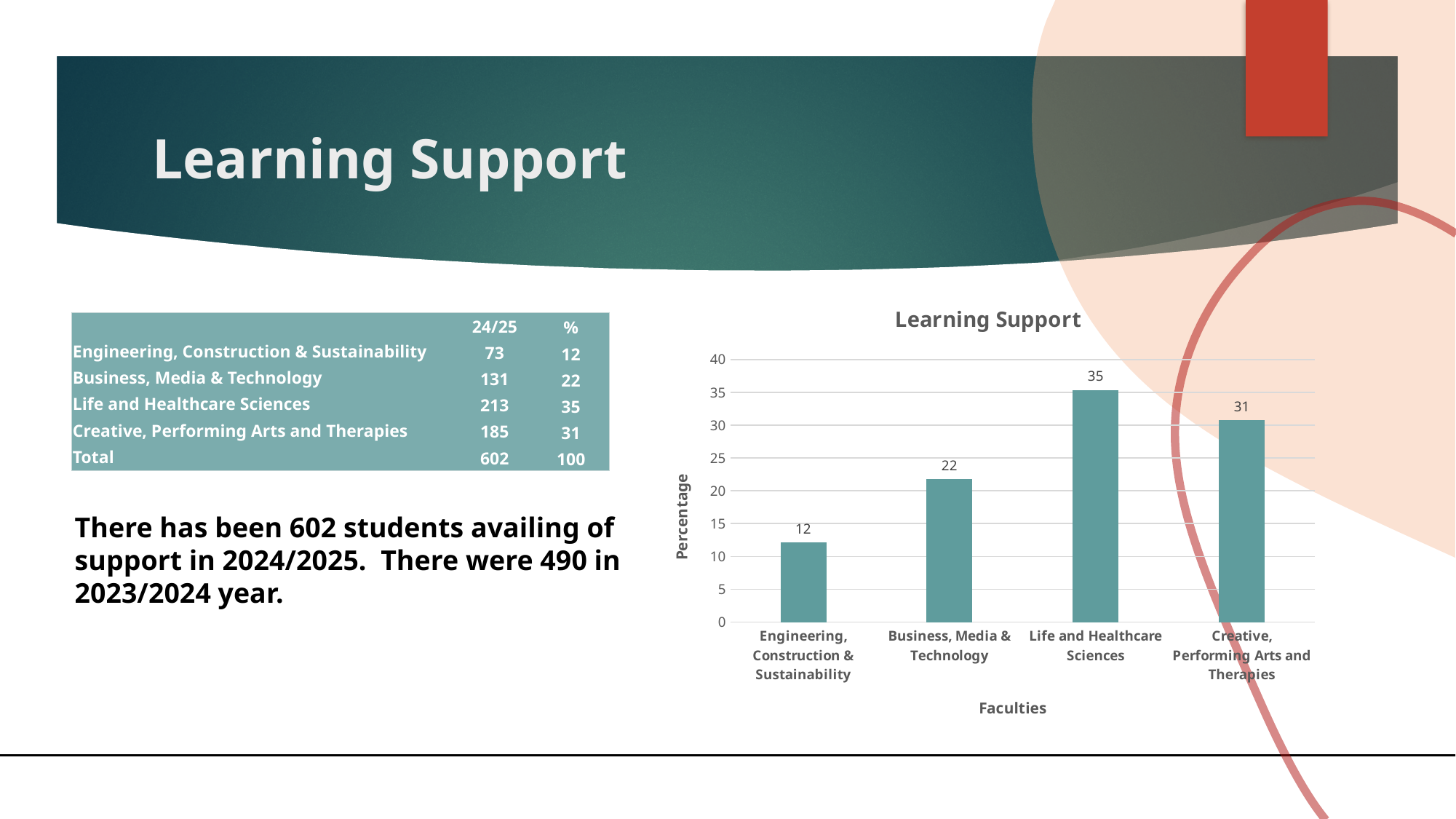
What is the difference between the values for Life and Healthcare Sciences and Business, Media & Technology in the Learning Support chart? 13 What is the label of the y axis in the Learning Support chart? Percentage Which faculty has the highest value in the Learning Support chart? Life and Healthcare Sciences What is the value for Life and Healthcare Sciences in the Learning Support chart? 35 In the Learning Support chart, which is larger: the value for Creative, Performing Arts and Therapies or the value for Business, Media & Technology? Creative, Performing Arts and Therapies What is the value for Engineering, Construction & Sustainability in the Learning Support chart? 12 What is the value for Creative, Performing Arts and Therapies in the Learning Support chart? 31 How many faculties are shown in the Learning Support chart? 4 Which faculty has the lowest value in the Learning Support chart? Engineering, Construction & Sustainability What is the value for Business, Media & Technology in the Learning Support chart? 22 What kind of chart is the Learning Support chart? bar chart Is the value for Creative, Performing Arts and Therapies in the Learning Support chart greater or less than 25? greater